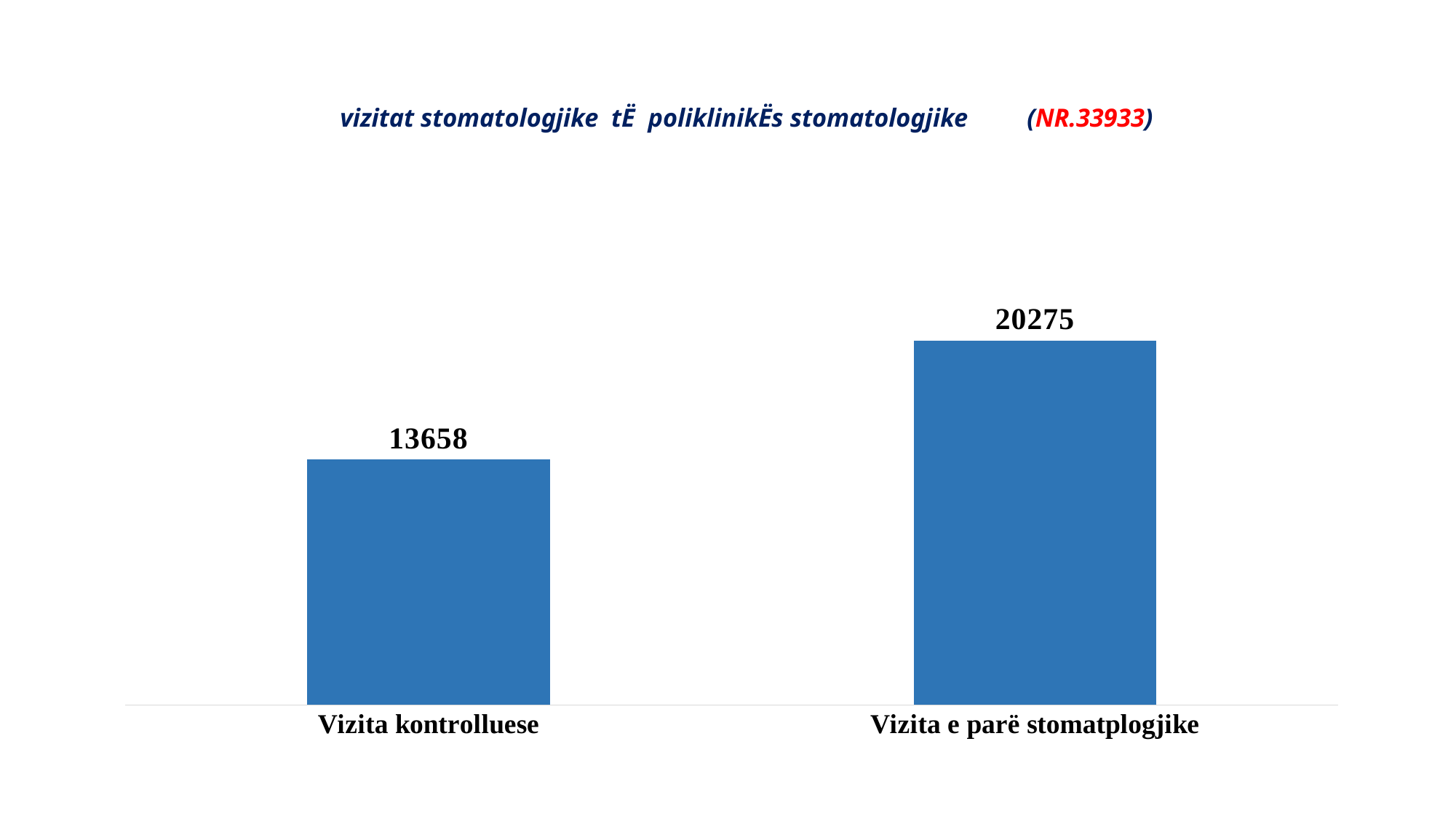
How many categories are shown in the chart? 2 What kind of chart is shown on the slide? Bar chart What is the total of the two values shown in the chart? 33933 Which is larger, the value for Vizita kontrolluese or the value for Vizita e parë stomatplogjike? Vizita e parë stomatplogjike What colour are the bars in the chart? Blue Which category has the highest value? Vizita e parë stomatplogjike What is the value for Vizita e parë stomatplogjike? 20275 What number is shown in red in the chart title? 33933 Which category has the lowest value? Vizita kontrolluese What is the value for Vizita kontrolluese? 13658 What is the difference between the values for Vizita e parë stomatplogjike and Vizita kontrolluese? 6617